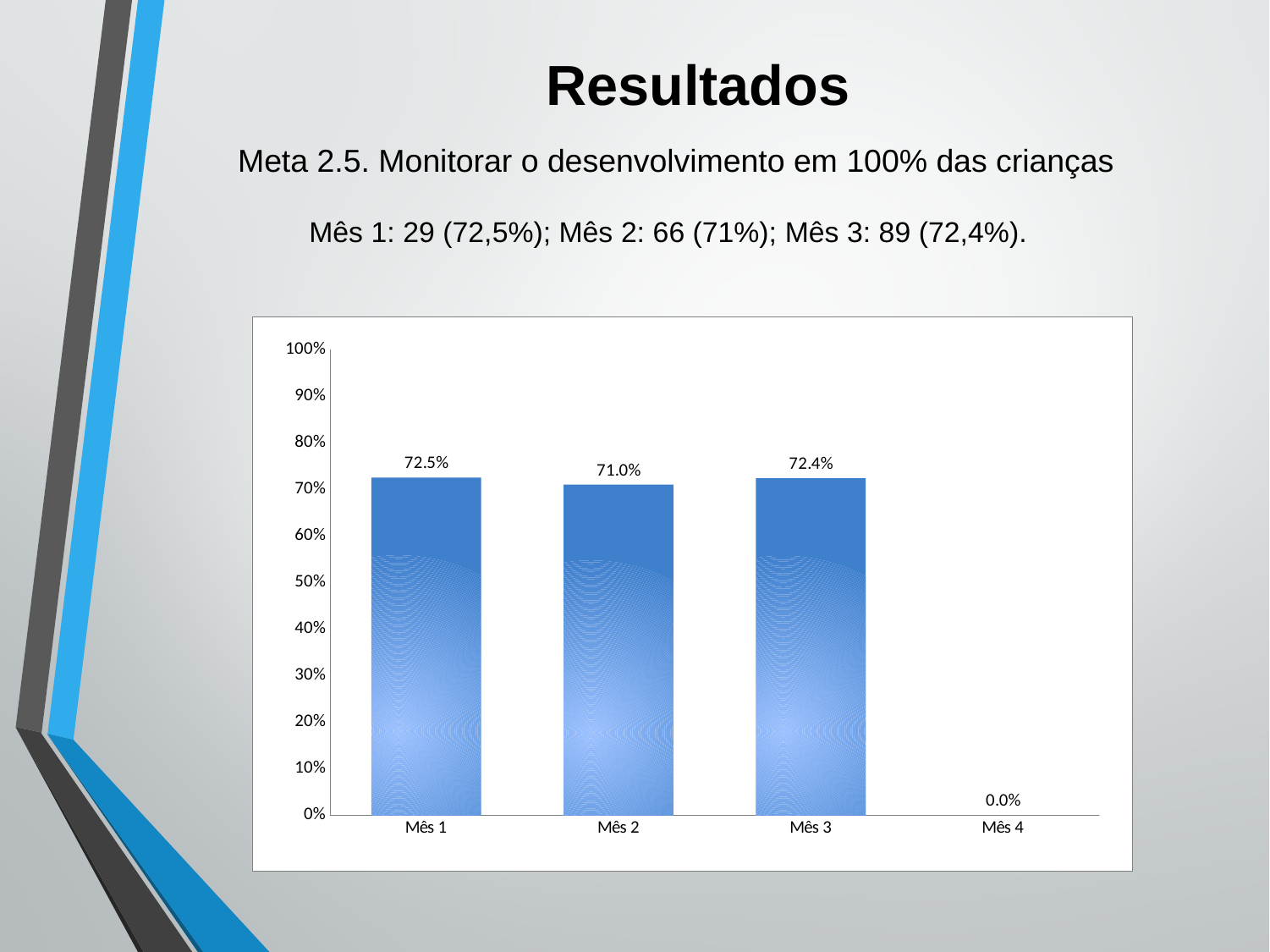
Is the value for Mês 3 greater or less than 60%? greater What is the value for Mês 2? 71.0% Which category has the lowest value? Mês 4 What is the value for Mês 1? 72.5% What is the difference between the values for Mês 1 and Mês 2? 1.5% How many categories are shown on the x axis? 4 Which is larger, the value for Mês 1 or the value for Mês 2? Mês 1 What is the title of the slide containing the chart? Resultados What kind of chart is shown on the slide? bar chart What is the value for Mês 3? 72.4% What is the value for Mês 4? 0.0% Is the value for Mês 2 greater or less than 80%? less